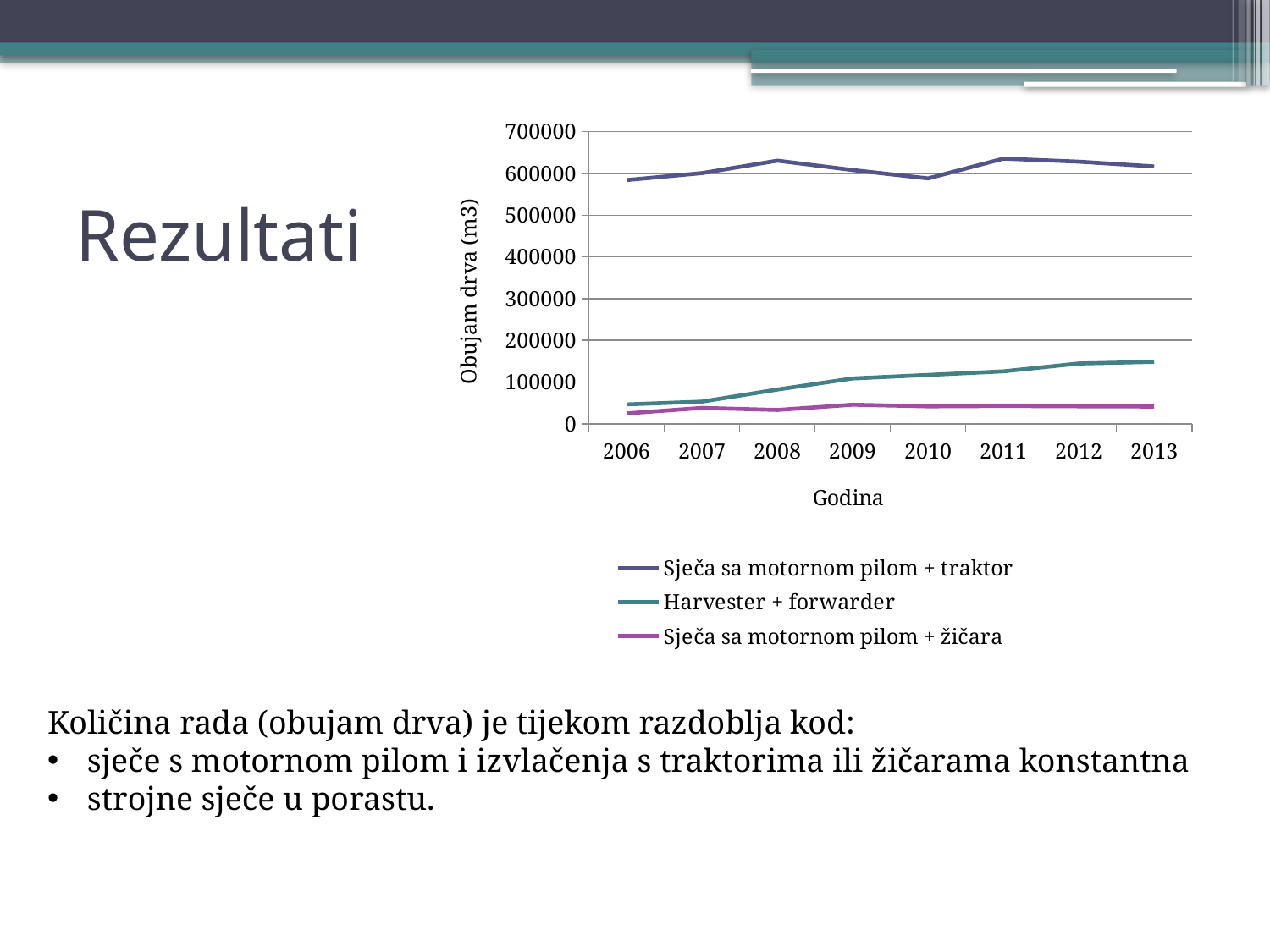
What kind of chart is shown on the slide? line chart Is the value for Sječa sa motornom pilom + traktor in 2006 greater or less than 500000? greater Is the value for Harvester + forwarder in 2006 greater or less than 100000? less In 2013, which is larger: Harvester + forwarder or Sječa sa motornom pilom + žičara? Harvester + forwarder In which year is the value for Harvester + forwarder lowest? 2006 Which series has the highest values across all years? Sječa sa motornom pilom + traktor Is the value for Harvester + forwarder in 2013 greater or less than 100000? greater Does the value for Harvester + forwarder rise or fall from 2006 to 2013? rise How many years are shown on the x axis? 8 How many series does the legend list? 3 What is the label of the vertical axis? Obujam drva (m3)